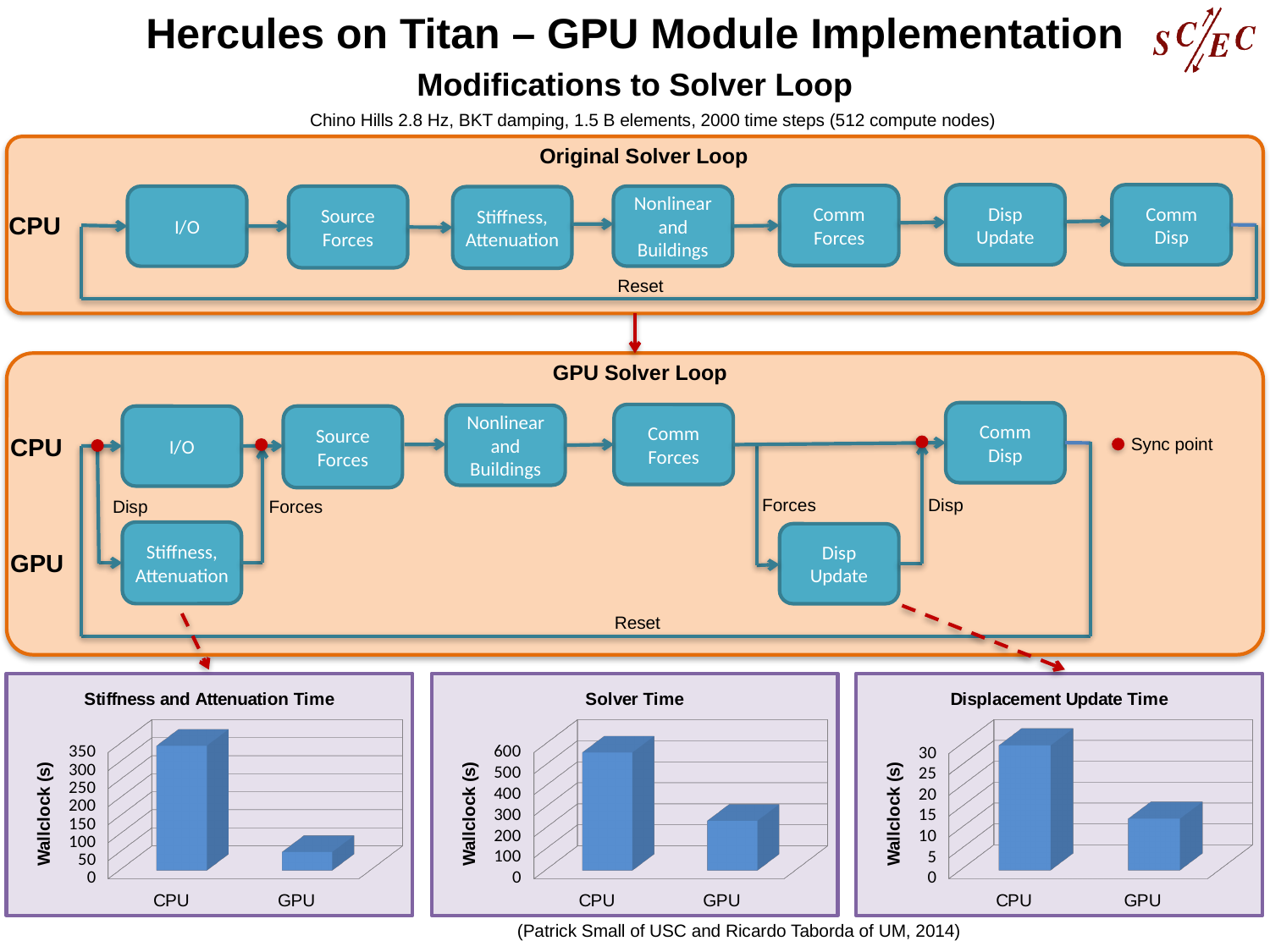
In the Solver Time chart, is the value for CPU greater or less than 500? greater What is the y-axis label of the Stiffness and Attenuation Time chart? Wallclock (s) In the Stiffness and Attenuation Time chart, is the value for CPU greater or less than 300? greater What kind of chart is the Displacement Update Time chart? Bar chart In the Stiffness and Attenuation Time chart, is the value for GPU greater or less than 100? less In the Stiffness and Attenuation Time chart, which category has the higher wallclock time, CPU or GPU? CPU How many categories are shown on the x axis of the Solver Time chart? 2 In the Solver Time chart, which category has the lowest wallclock time? GPU In the Displacement Update Time chart, which category has the highest wallclock time? CPU